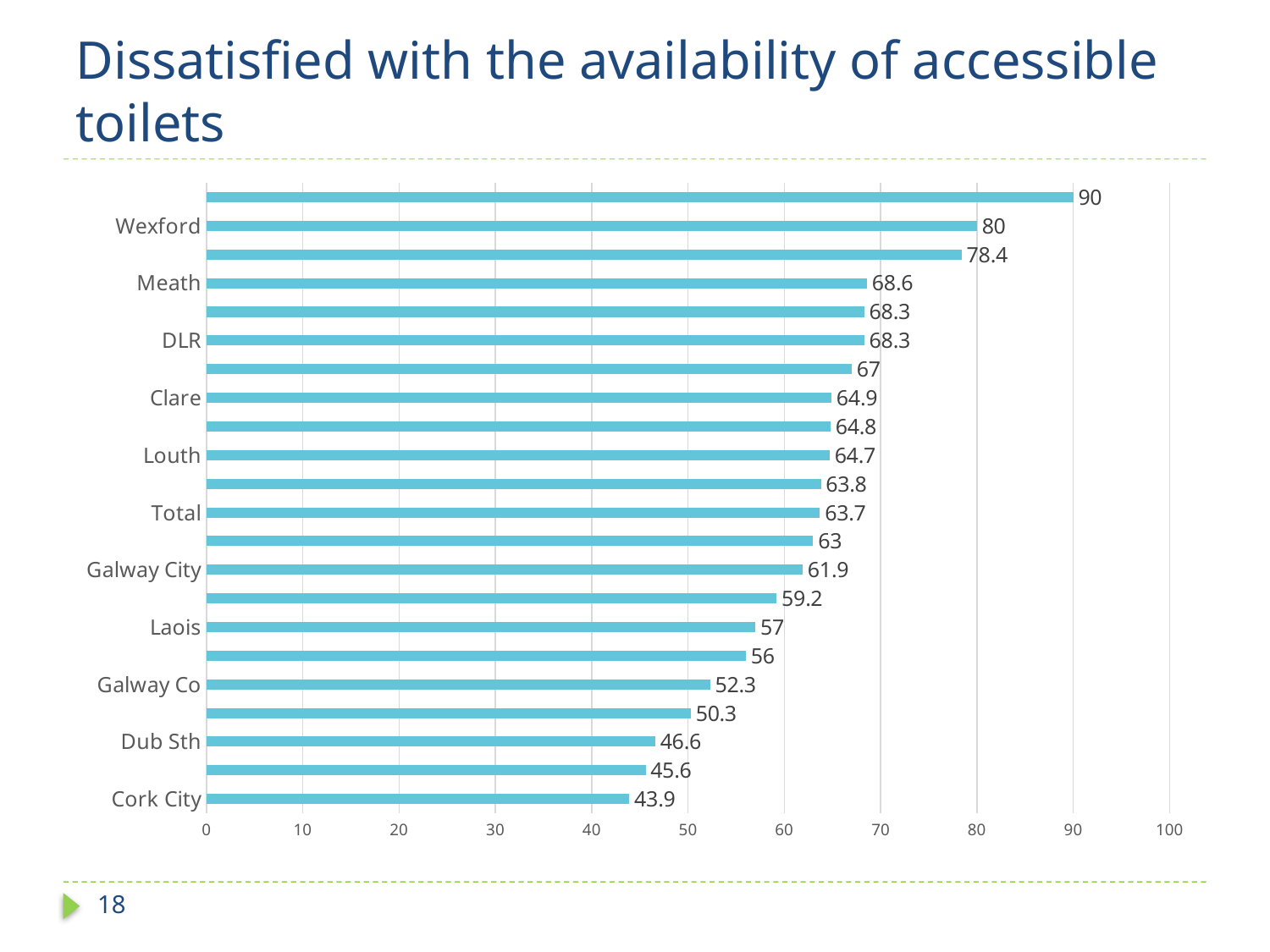
How many bars are plotted in the chart? 22 What is the title of the slide? Dissatisfied with the availability of accessible toilets What is the value for Meath? 68.6 What is the value for Wexford? 80 What kind of chart is shown on the slide? bar chart Which labelled category has the lowest value? Cork City What is the value for Cork City? 43.9 Which is larger, the value for Laois or the value for Dub Sth? Laois What is the value for Total? 63.7 What is the difference between the values for Wexford and Cork City? 36.1 What is the value for Galway Co? 52.3 Is the value for Clare greater or less than 60? greater